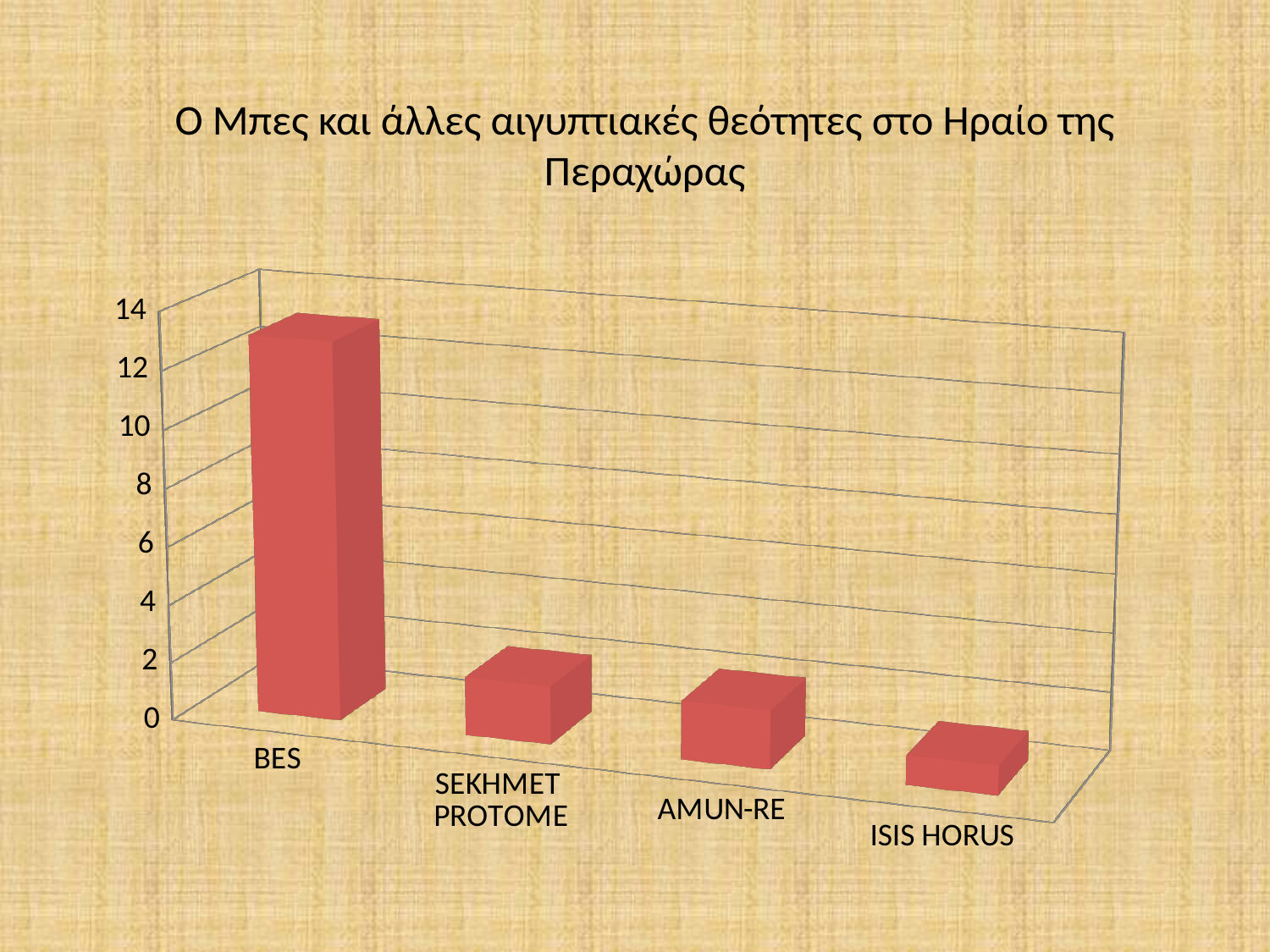
Which is larger, the value for SEKHMET PROTOME or the value for ISIS HORUS? SEKHMET PROTOME Is the value for SEKHMET PROTOME greater or less than 4? less Which category has the highest bar? BES What kind of chart is shown on the slide? bar chart Do the bar values generally rise or fall from left to right along the x axis? fall Is the value for ISIS HORUS greater or less than 2? less What colour are the bars in the chart? red Which category has the lowest bar? ISIS HORUS Is the value for AMUN-RE greater or less than 6? less Which is larger, the value for BES or the value for AMUN-RE? BES How many categories are shown on the x axis of the chart? 4